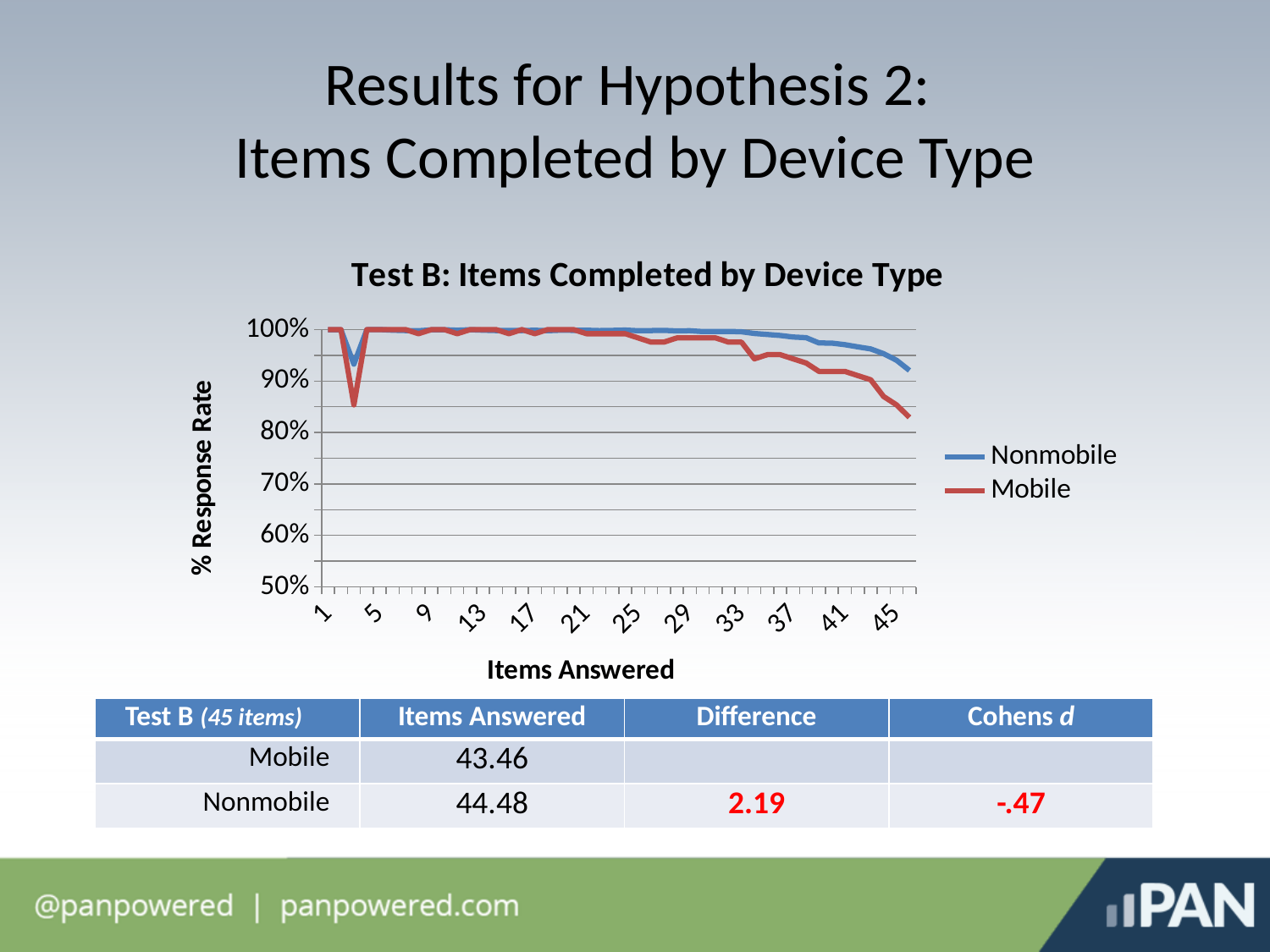
What is the label of the vertical axis of the chart? % Response Rate What is the highest value shown on the vertical axis of the chart? 100% Which series ends with the lowest response rate at the right end of the chart? Mobile Is the value for Nonmobile at item 45 greater or less than 90%? greater Do the values of the Mobile series rise or fall as the number of items answered increases? fall Do the values of the Nonmobile series rise or fall along the x axis overall? fall What is the title of the chart? Test B: Items Completed by Device Type At item 45, which series has the higher response rate, Nonmobile or Mobile? Nonmobile How many series does the legend of the chart list? 2 What kind of chart is shown on the slide? line chart Is the value for Mobile at item 45 greater or less than 80%? greater Is the value for Mobile at item 45 greater or less than 90%? less